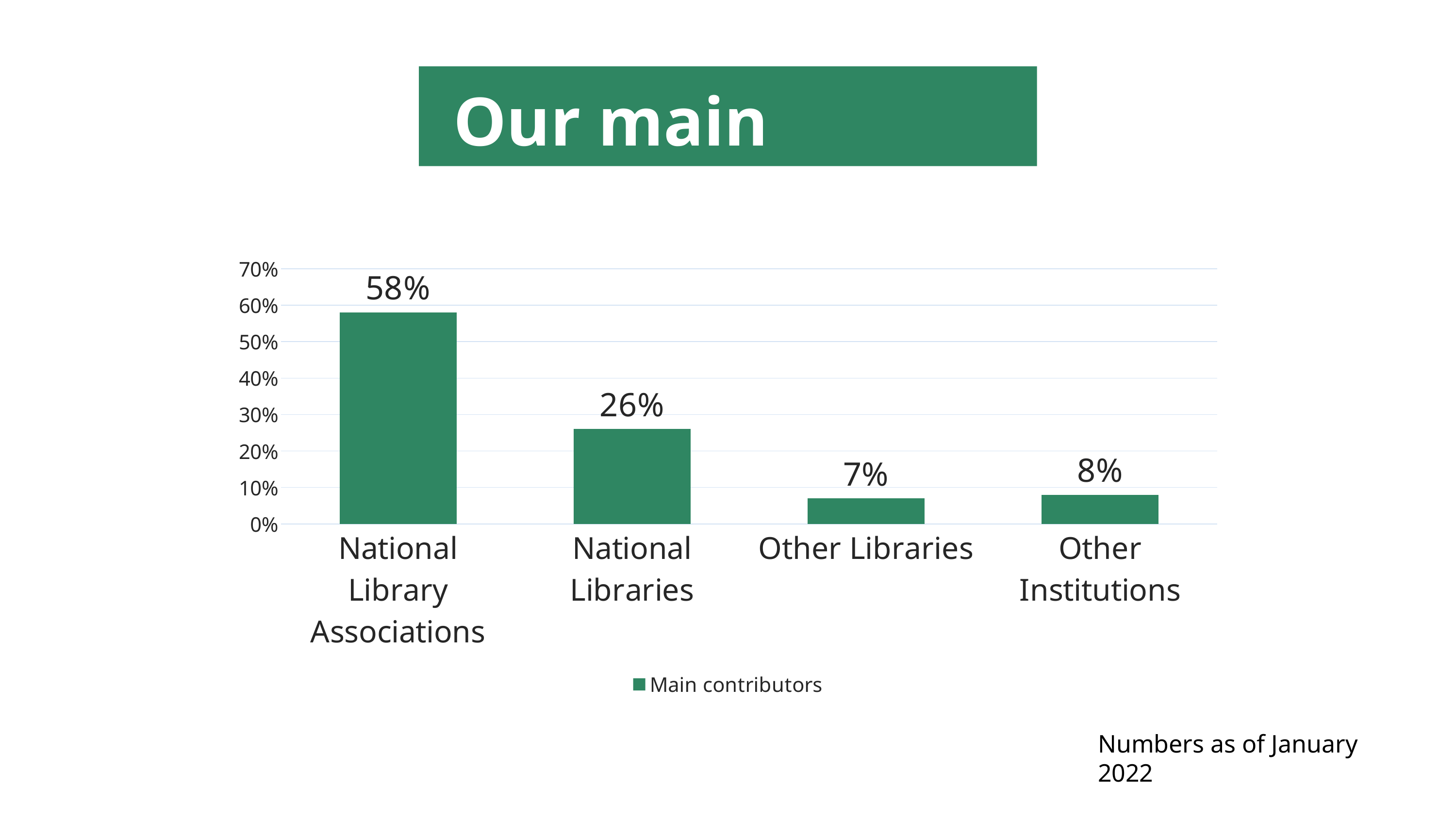
Which category has the lowest value? Other Libraries What is the value for National Library Associations? 58% Is the value for National Libraries greater or less than 30%? less What series name does the legend show? Main contributors How many categories are shown on the x axis? 4 What is the difference between the values for National Library Associations and National Libraries? 32% Which category has the highest value? National Library Associations What kind of chart is shown on the slide? bar chart What is the value for Other Institutions? 8% Which is larger, the value for National Libraries or the value for Other Institutions? National Libraries What is the value for Other Libraries? 7% What is the value for National Libraries? 26%